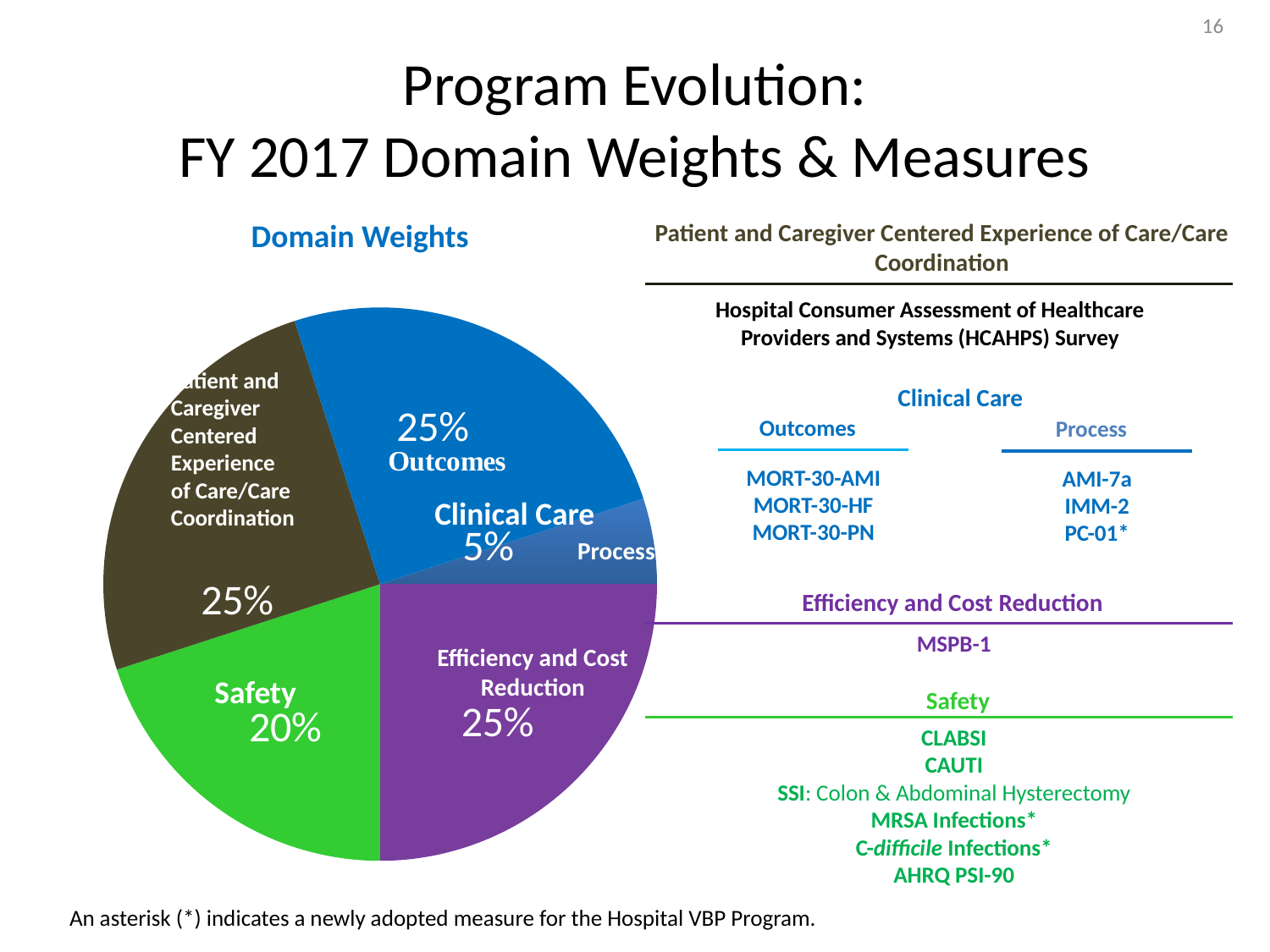
What is the title of the pie chart on the slide? Domain Weights How many slices does the Domain Weights pie chart have? 5 In the Domain Weights pie chart, which is larger: Safety or Process? Safety What is the weight shown for the Safety slice in the Domain Weights pie chart? 20% What is the weight shown for the Process slice in the Domain Weights pie chart? 5% What is the weight shown for the Outcomes slice in the Domain Weights pie chart? 25% What is the weight shown for the Patient and Caregiver Centered Experience of Care/Care Coordination slice in the Domain Weights pie chart? 25% In the Domain Weights pie chart, what is the combined weight of the Outcomes and Process slices (Clinical Care)? 30% Which slice of the Domain Weights pie chart is the smallest? Process In the Domain Weights pie chart, what is the difference between the Safety weight and the Process weight? 15% What is the weight shown for the Efficiency and Cost Reduction slice in the Domain Weights pie chart? 25% What kind of chart is the Domain Weights chart? pie chart